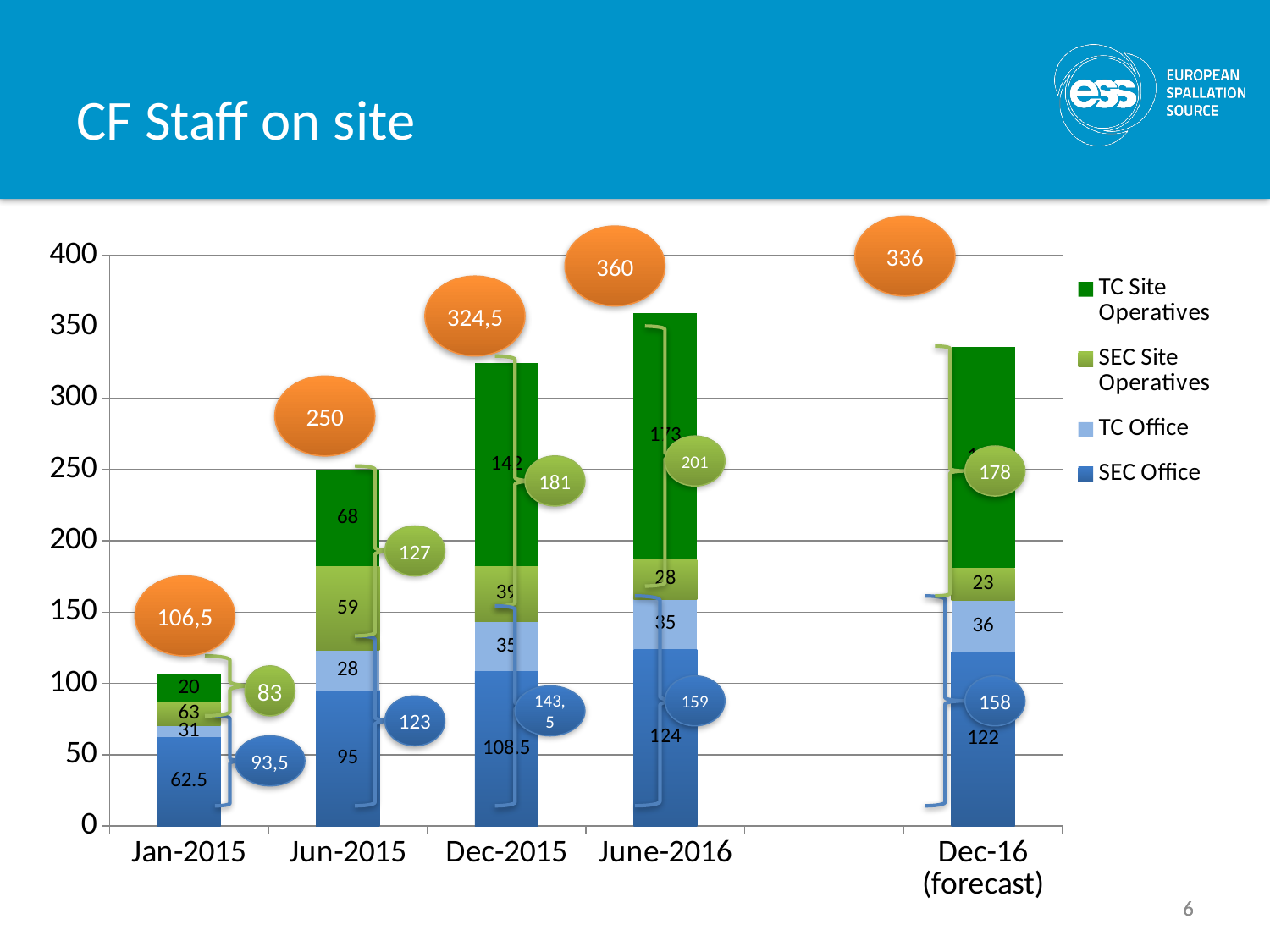
How many time periods are shown on the x axis? 5 How many series does the legend list? 4 What kind of chart is shown on the slide? Stacked bar chart What is the SEC Office value for Jun-2015? 95 Which period has the lowest total bar? Jan-2015 Which period has the highest total bar? June-2016 What is the SEC Site Operatives value for June-2016? 28 What is the difference between the SEC Office values for June-2016 and Jun-2015? 29 Do the total bar heights rise or fall from Jan-2015 to June-2016? Rise What is the total staff on site shown for June-2016? 360 What is the TC Office value for Dec-16 (forecast)? 36 What is the SEC Office value for Dec-2015? 108.5